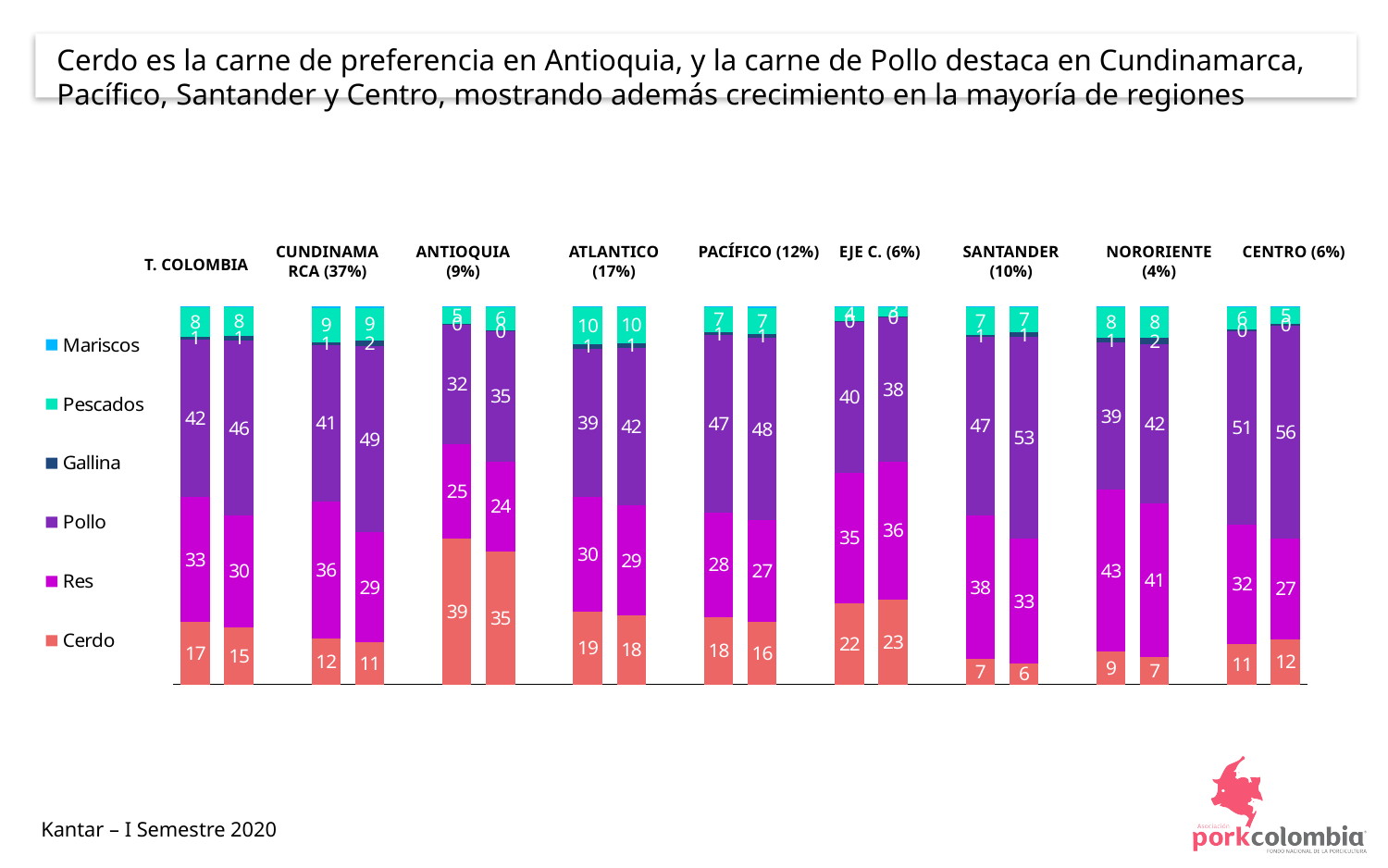
What is the Res value in the left bar for NORORIENTE (4%)? 43 What is the Pescados value in the left bar for ATLANTICO (17%)? 10 How many series does the legend list? 6 What is the Cerdo value in the left bar for ANTIOQUIA (9%)? 39 What is the difference between the Pollo values in the right and left bars for CENTRO (6%)? 5 Which region has the lowest Cerdo value in its right bar? SANTANDER (10%) What kind of chart is shown on the slide? Stacked bar chart Which legend entry is shown in orange/salmon colour? Cerdo How many regions (category groups) are shown along the x axis? 9 In the left bar for ANTIOQUIA (9%), which is larger, Cerdo or Res? Cerdo Which region has the highest Cerdo value in its left bar? ANTIOQUIA (9%) What is the Pollo value in the right bar for CENTRO (6%)? 56